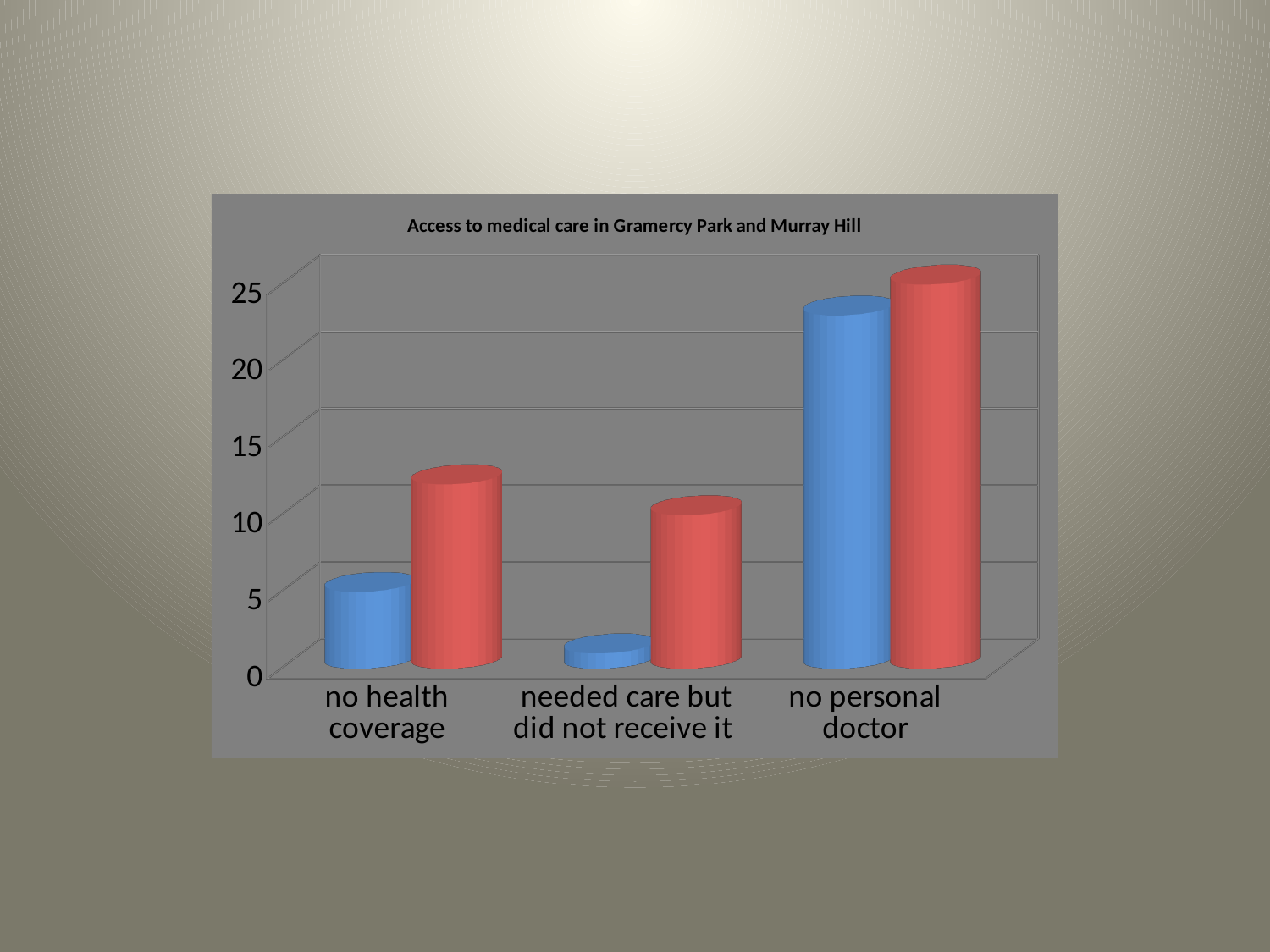
Is the value of the red bar for 'needed care but did not receive it' greater or less than 5? greater How many bars are plotted for each category in the chart? 2 Is the value of the blue bar for 'no personal doctor' greater or less than 20? greater Is the value of the red bar for 'no health coverage' greater or less than 10? greater What is the title of the chart? Access to medical care in Gramercy Park and Murray Hill How many categories are shown on the x axis of the chart? 3 Which category has the lowest blue bar? needed care but did not receive it Which category has the highest blue bar? no personal doctor For 'no health coverage', which bar is larger, the blue one or the red one? the red one What kind of chart is shown on the slide? bar chart